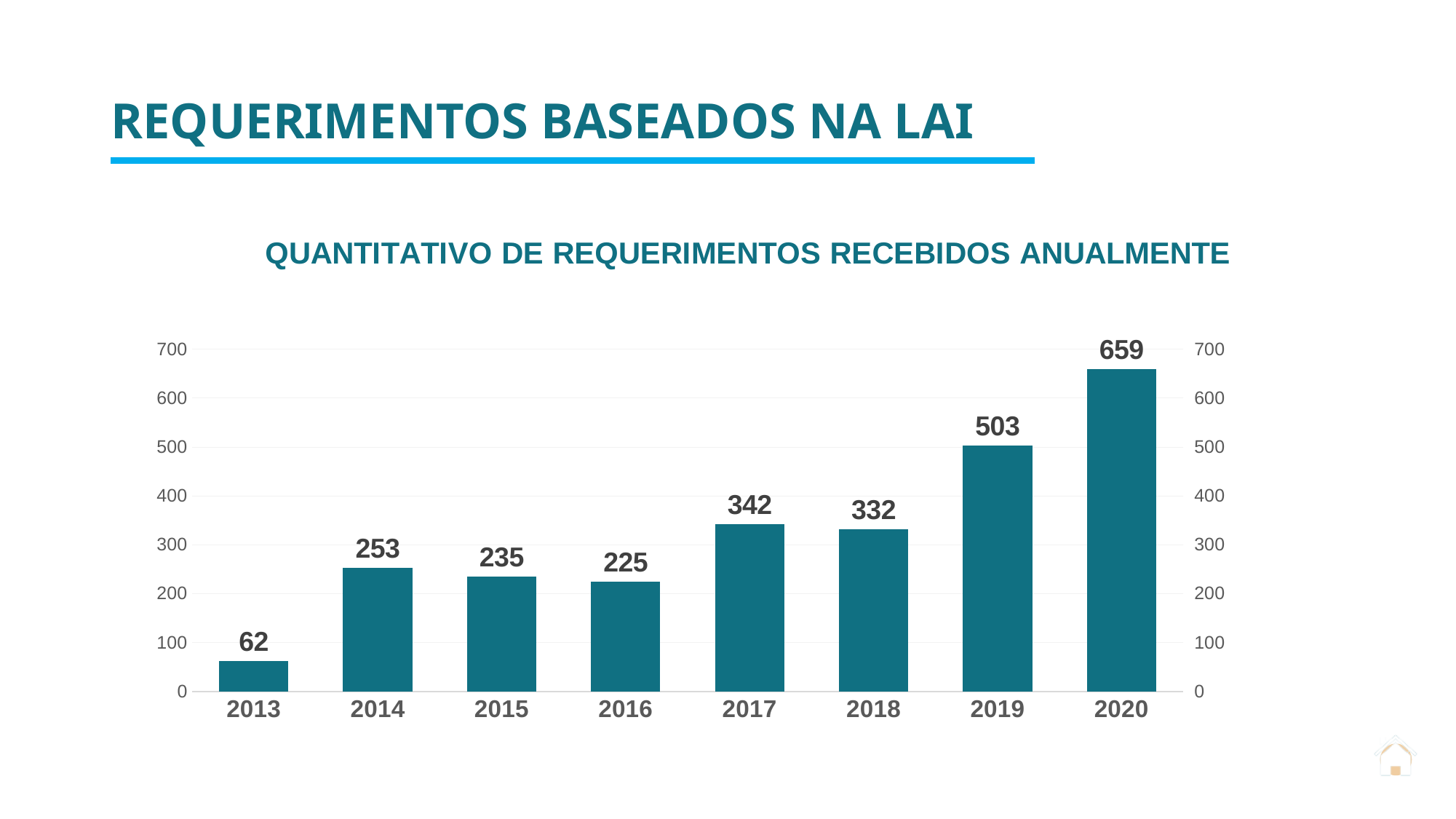
Which is larger, the value for 2017 or the value for 2018? 2017 Which year has the lowest value? 2013 Is the value for 2019 greater or less than 400? greater Which year has the highest value? 2020 What is the value for 2017? 342 What kind of chart is shown on the slide? bar chart What is the value for 2020? 659 What is the value for 2013? 62 What is the difference between the values for 2014 and 2013? 191 What is the difference between the values for 2020 and 2019? 156 What is the title of the chart? QUANTITATIVO DE REQUERIMENTOS RECEBIDOS ANUALMENTE How many years are shown on the x axis? 8